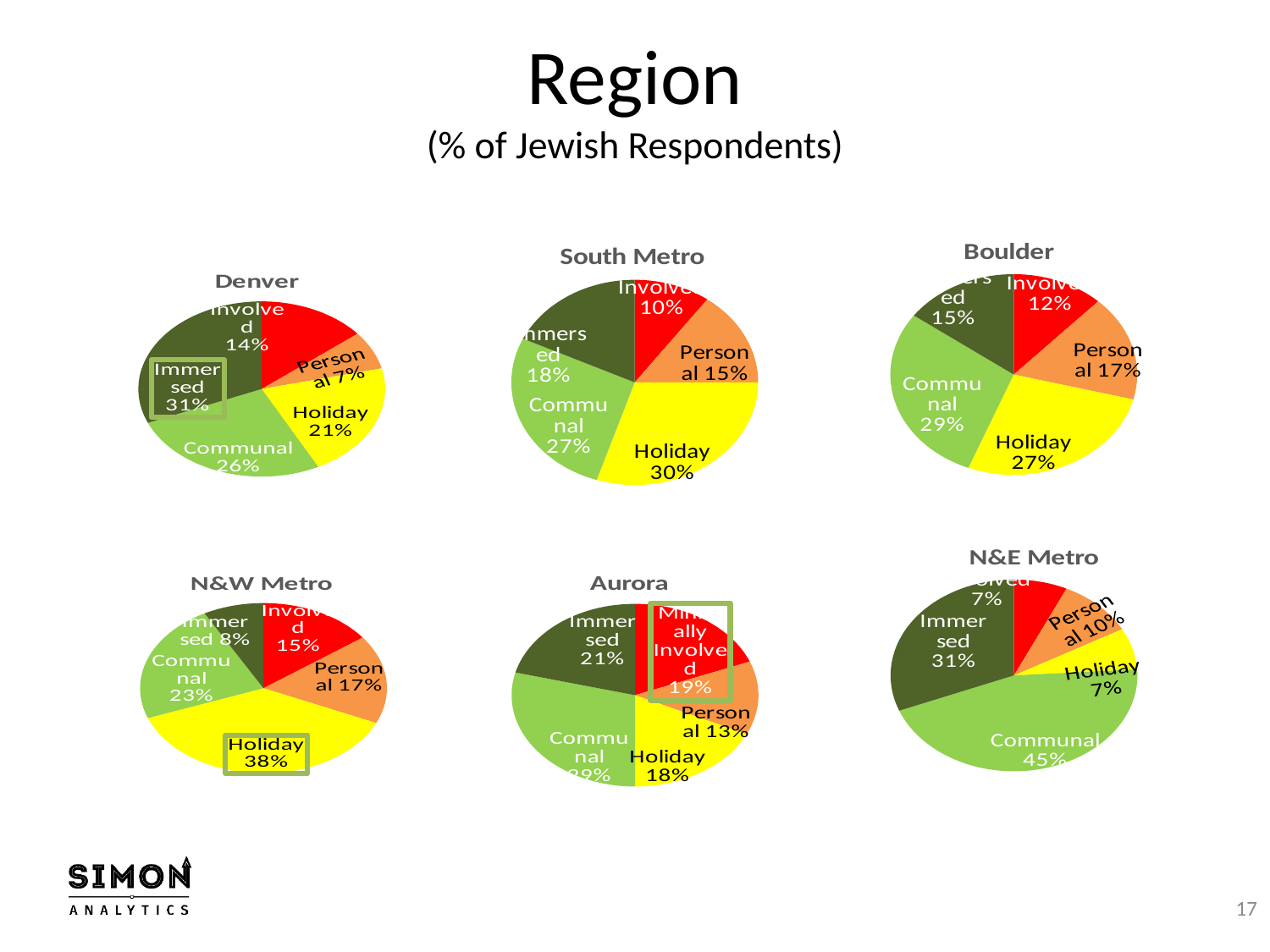
In the N&W Metro pie chart, what percentage is Holiday? 38% In the South Metro pie chart, which is larger, Communal or Immersed? Communal What type of chart is used for each region on the slide? Pie chart In the N&E Metro pie chart, which category has the largest share? Communal In the Boulder pie chart, which category has the largest share? Communal In the Boulder pie chart, what is the difference between Holiday and Personal? 10% In the Denver pie chart, what percentage is Immersed? 31% In the Aurora pie chart, what percentage is Immersed? 21% In the Denver pie chart, which category has the smallest share? Personal How many pie charts are shown on the slide? 6 In the South Metro pie chart, what percentage is Holiday? 30% In the N&E Metro pie chart, what percentage is Personal? 10%